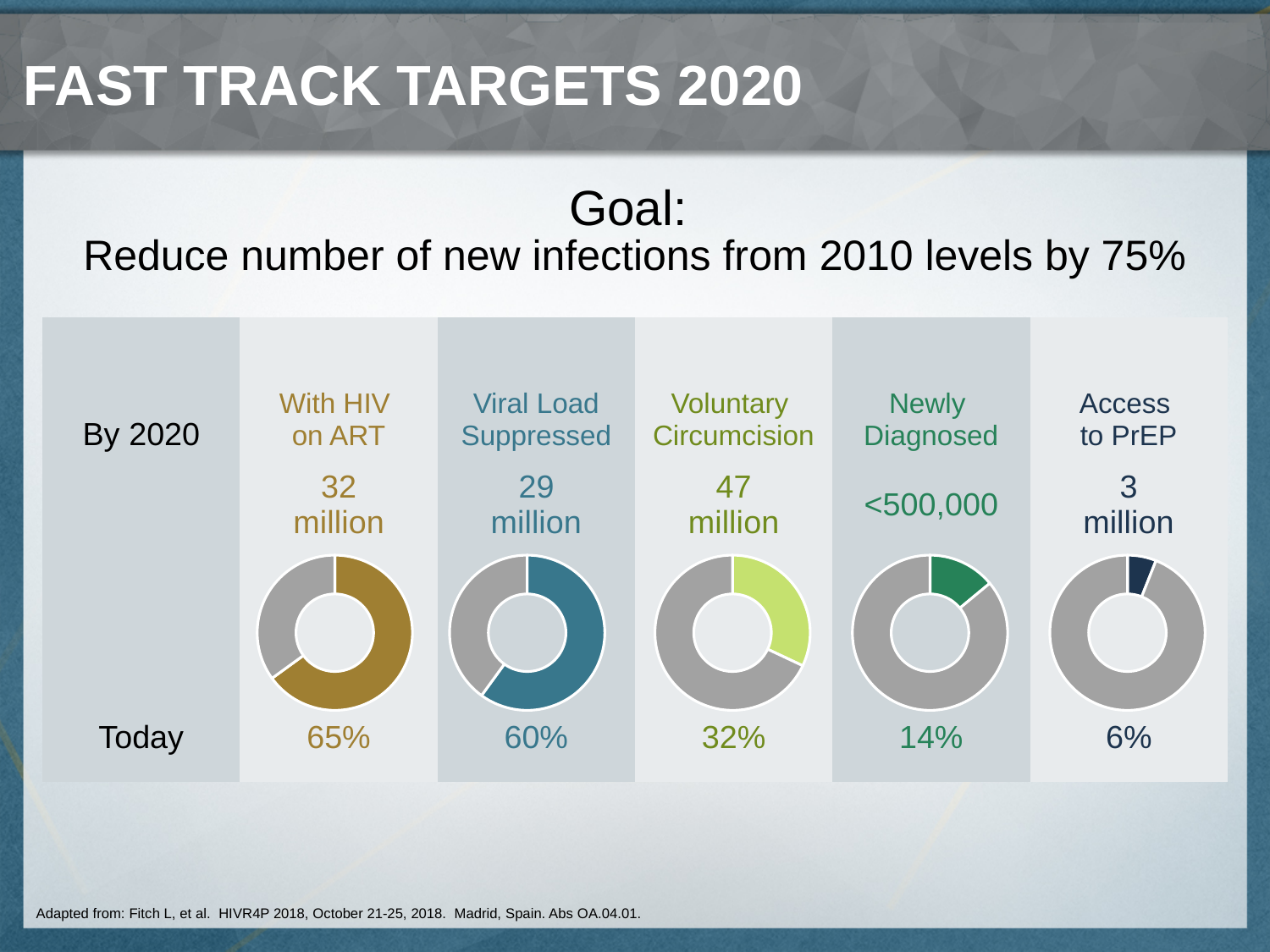
In the 'Viral Load Suppressed' donut chart, what is the 'Today' value shown? 60% In the 'Access to PrEP' donut chart, what is the 'Today' value shown? 6% What is the 'By 2020' target shown above the 'Voluntary Circumcision' donut chart? 47 million What is the difference between the 'Today' values of the 'With HIV on ART' chart and the 'Viral Load Suppressed' chart? 5% In the 'With HIV on ART' donut chart, what is the 'Today' value shown? 65% Across the five donut charts, which category has the lowest 'Today' percentage? Access to PrEP Across the five donut charts, which category has the highest 'Today' percentage? With HIV on ART In the 'Newly Diagnosed' donut chart, what is the 'Today' value shown? 14% What type of chart is used to show the 'Today' values on the slide? Donut (pie) chart How many donut charts are shown on the slide? 5 In the 'Voluntary Circumcision' donut chart, what is the 'Today' value shown? 32% Which has a larger 'Today' value: the 'Voluntary Circumcision' chart or the 'Newly Diagnosed' chart? Voluntary Circumcision